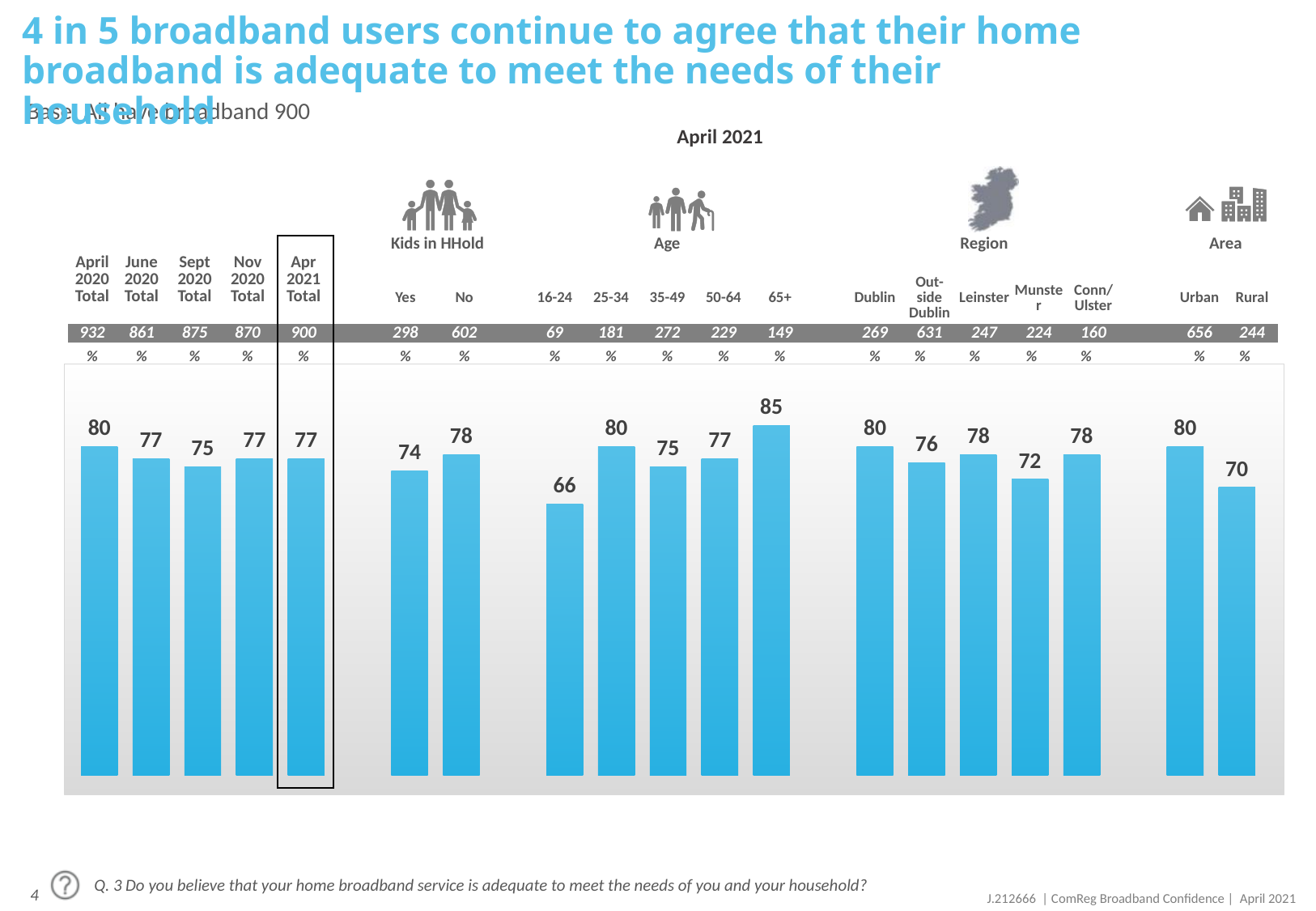
What is the value for Rural in the Area section? 70 What is the difference between the values for Urban and Rural? 10 Which category has the highest value on the chart? 65+ How many bars are plotted on the chart? 19 What is the value for the 65+ age group? 85 What is the value for Munster? 72 What is the difference between the values for the 65+ and 16-24 age groups? 19 What is the value for the Apr 2021 Total? 77 Which is larger, the value for Kids in HHold Yes or No? No What kind of chart is shown on the slide? Bar chart Which category has the lowest value on the chart? 16-24 Which is larger, the value for Dublin or Outside Dublin? Dublin